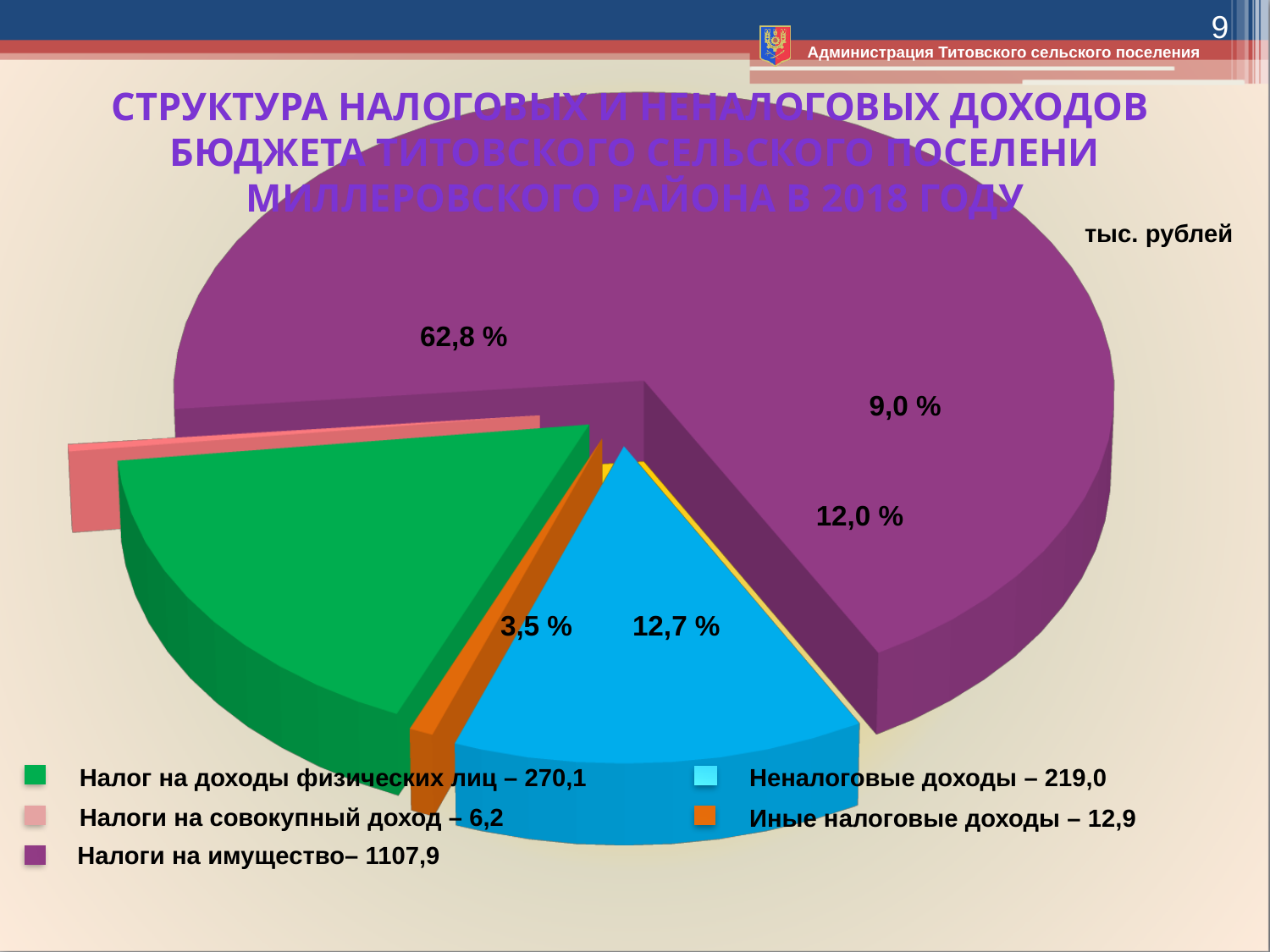
What is the value for Налог на доходы физических лиц? 270,1 What kind of chart is shown on the slide? pie chart Which category has the lowest value? Налоги на совокупный доход What is the value for Неналоговые доходы? 219,0 What is the value for Иные налоговые доходы? 12,9 Which is larger, Неналоговые доходы or Иные налоговые доходы? Неналоговые доходы What is the value for Налоги на совокупный доход? 6,2 What is the difference between the values for Налог на доходы физических лиц and Неналоговые доходы? 51,1 Which category has the highest value? Налоги на имущество How many categories does the legend of the pie chart list? 5 What is the value for Налоги на имущество? 1107,9 What percentage label is shown on the largest (purple) slice of the pie? 62,8 %